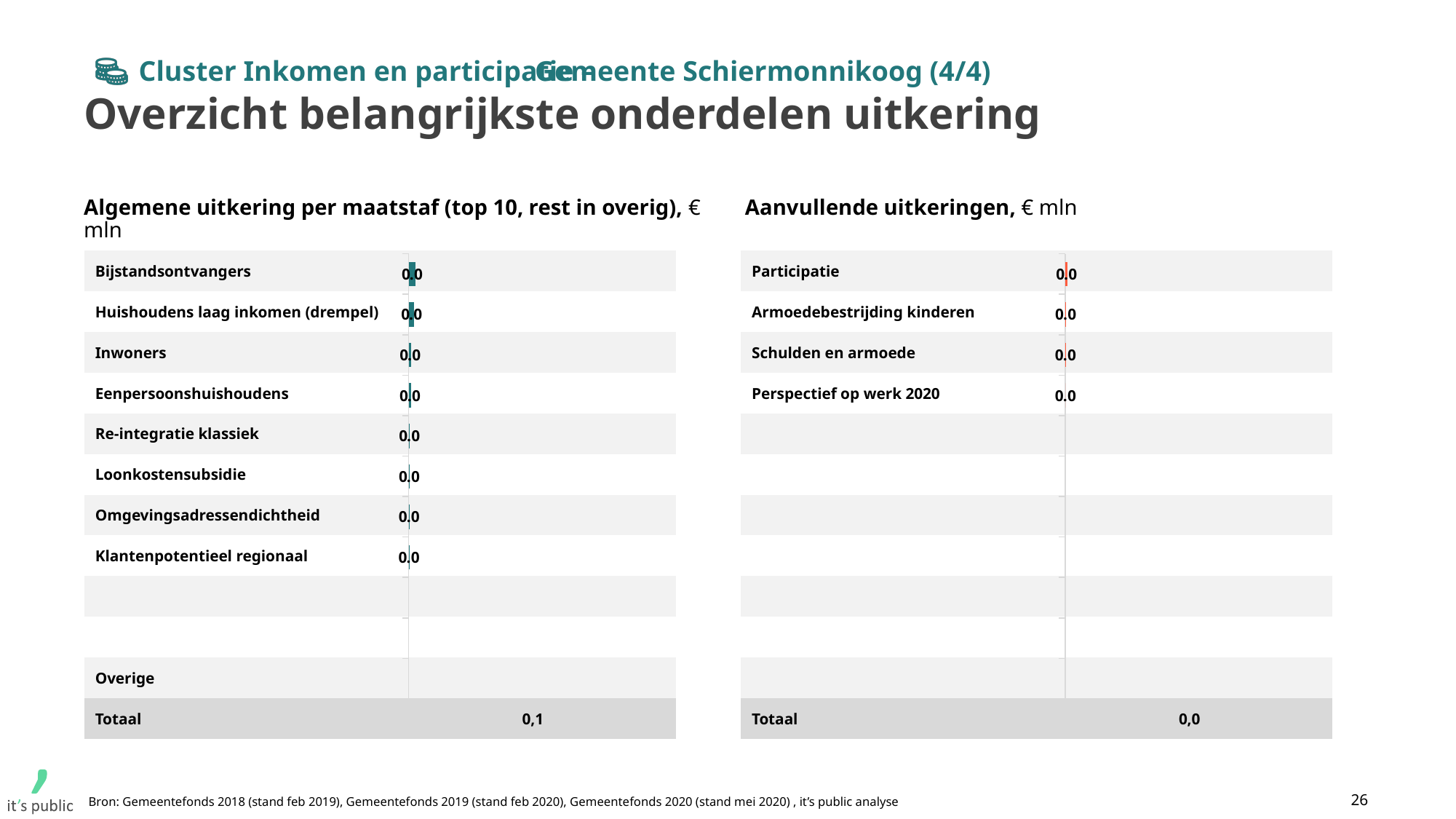
In the left chart 'Algemene uitkering per maatstaf', what is the value for Bijstandsontvangers? 0.0 What kind of chart is the left chart 'Algemene uitkering per maatstaf'? Bar chart In the right chart 'Aanvullende uitkeringen', what is the Totaal value shown? 0,0 In the right chart 'Aanvullende uitkeringen', what is the value for Perspectief op werk 2020? 0.0 What unit is stated in the title of the right chart 'Aanvullende uitkeringen'? € mln In the left chart 'Algemene uitkering per maatstaf', what is the Totaal value shown? 0,1 In the right chart 'Aanvullende uitkeringen', what is the value for Participatie? 0.0 How many named categories (excluding Overige and Totaal) are listed in the left chart 'Algemene uitkering per maatstaf'? 8 In the left chart 'Algemene uitkering per maatstaf', what is the value for Klantenpotentieel regionaal? 0.0 In the left chart 'Algemene uitkering per maatstaf', what is the value for Huishoudens laag inkomen (drempel)? 0.0 How many named categories (excluding Totaal) are listed in the right chart 'Aanvullende uitkeringen'? 4 Which category is listed first in the right chart 'Aanvullende uitkeringen'? Participatie